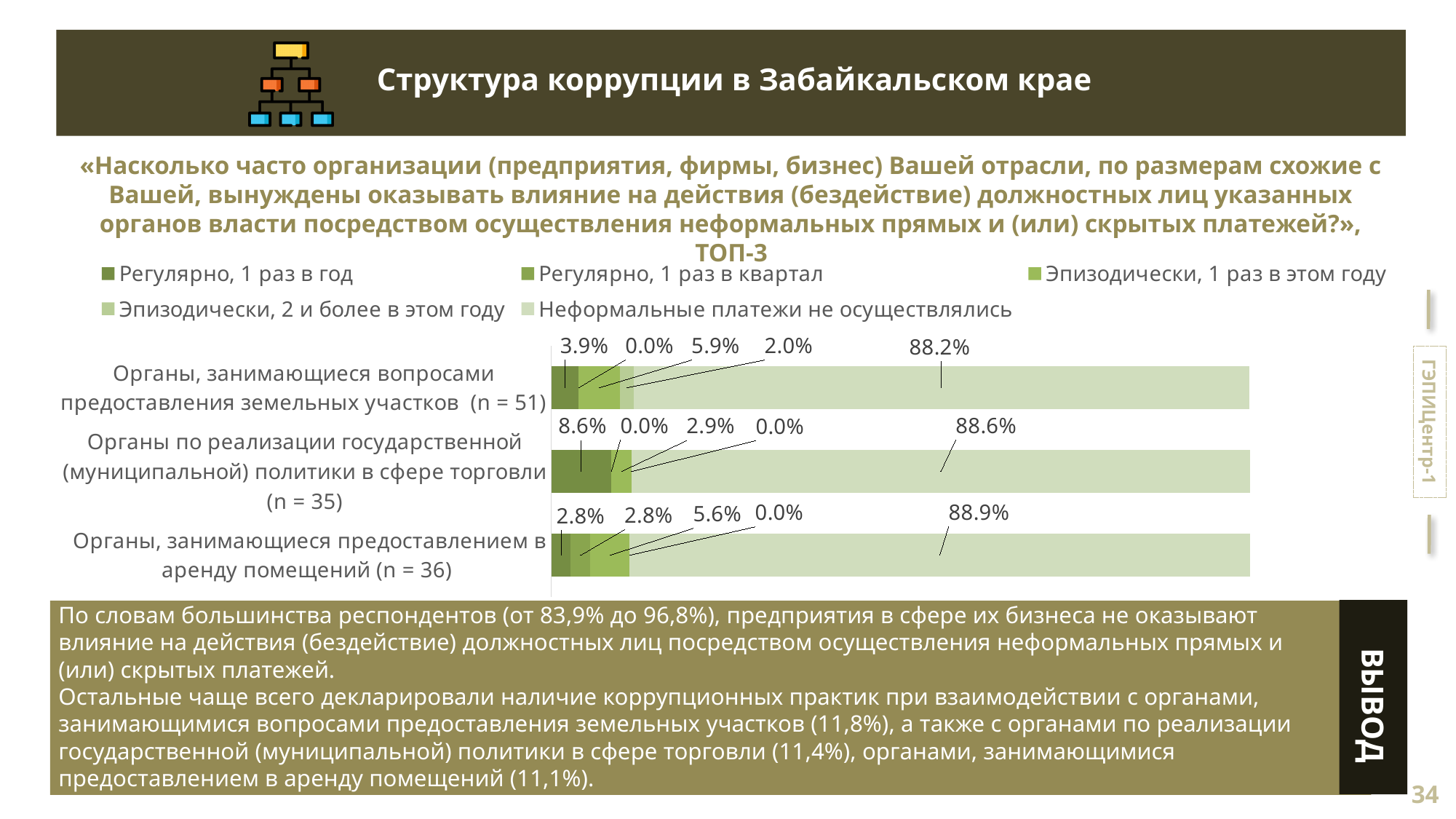
What is the value of «Неформальные платежи не осуществлялись» for «Органы, занимающиеся вопросами предоставления земельных участков (n = 51)»? 88.2% What is the value of «Эпизодически, 1 раз в этом году» for «Органы, занимающиеся предоставлением в аренду помещений (n = 36)»? 5.6% How many series does the legend list? 5 What kind of chart is shown on the slide? Stacked bar chart What is the value of «Регулярно, 1 раз в год» for «Органы по реализации государственной (муниципальной) политики в сфере торговли (n = 35)»? 8.6% Which legend entry is shown in the lightest green colour? Неформальные платежи не осуществлялись What is the value of «Эпизодически, 2 и более в этом году» for «Органы, занимающиеся вопросами предоставления земельных участков (n = 51)»? 2.0% Which category has the highest value for «Неформальные платежи не осуществлялись»? Органы, занимающиеся предоставлением в аренду помещений (n = 36) How many categories (groups of authorities) are plotted in the chart? 3 What is the difference between the «Регулярно, 1 раз в год» values for «Органы по реализации государственной (муниципальной) политики в сфере торговли (n = 35)» and «Органы, занимающиеся вопросами предоставления земельных участков (n = 51)»? 4.7% Which category has the highest value for «Регулярно, 1 раз в год»? Органы по реализации государственной (муниципальной) политики в сфере торговли (n = 35) Which is larger: the «Эпизодически, 1 раз в этом году» value for «Органы, занимающиеся вопросами предоставления земельных участков (n = 51)» or for «Органы по реализации государственной (муниципальной) политики в сфере торговли (n = 35)»? Органы, занимающиеся вопросами предоставления земельных участков (n = 51)